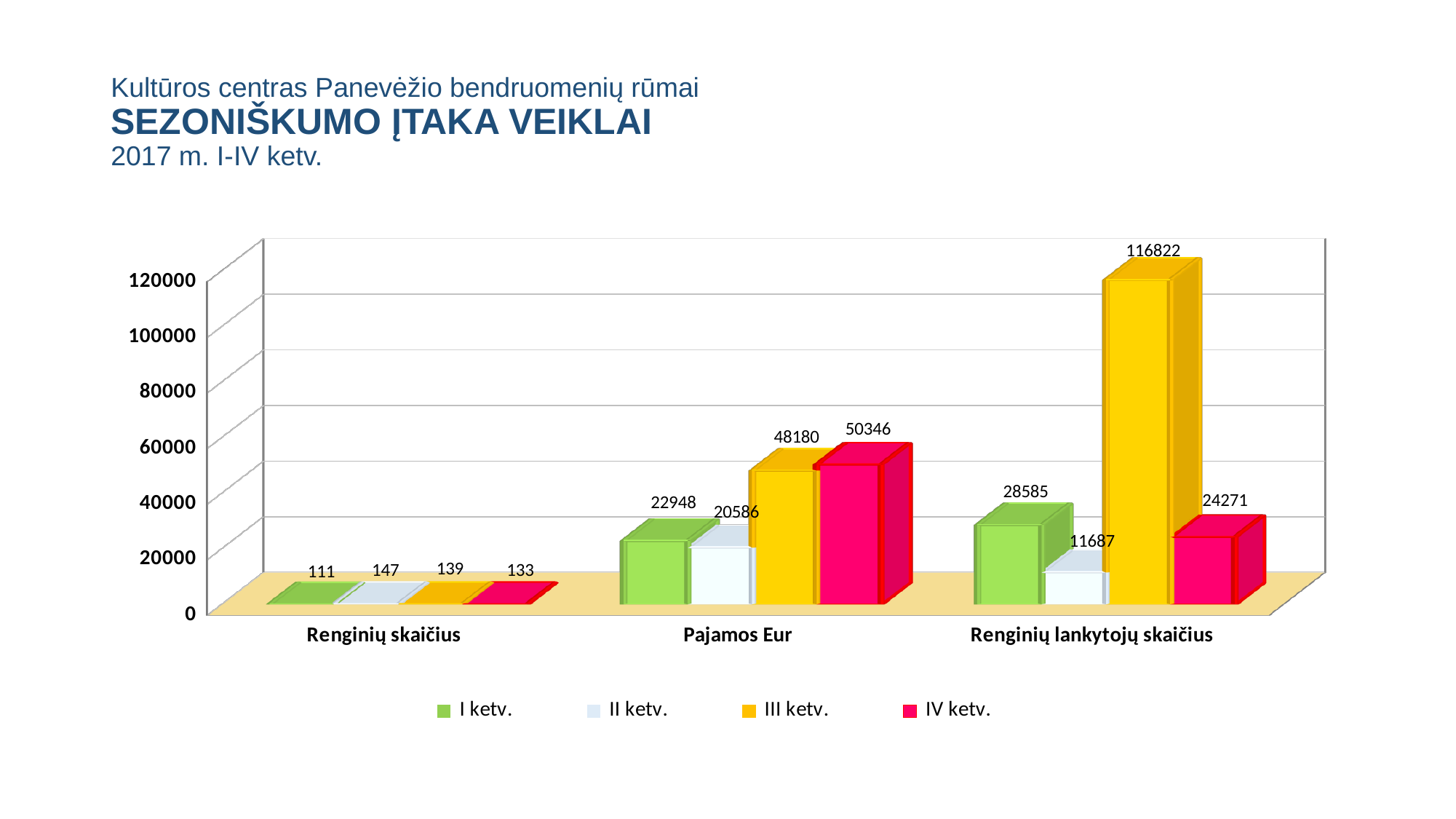
What is the difference between the IV ketv. and III ketv. values in the Pajamos Eur category? 2166 How many series does the legend list? 4 What is the value for II ketv. in the Renginių skaičius category? 147 What kind of chart is shown on the slide? Bar chart What is the value for III ketv. in the Renginių lankytojų skaičius category? 116822 Which quarter has the highest value in the Renginių lankytojų skaičius category? III ketv. Which colour represents III ketv. in the legend? Yellow What is the value for IV ketv. in the Pajamos Eur category? 50346 How many categories are shown on the x axis? 3 Which is larger in the Renginių lankytojų skaičius category: I ketv. or IV ketv.? I ketv. Which quarter has the lowest value in the Pajamos Eur category? II ketv. Is the value for III ketv. in the Renginių lankytojų skaičius category greater or less than 100000? greater